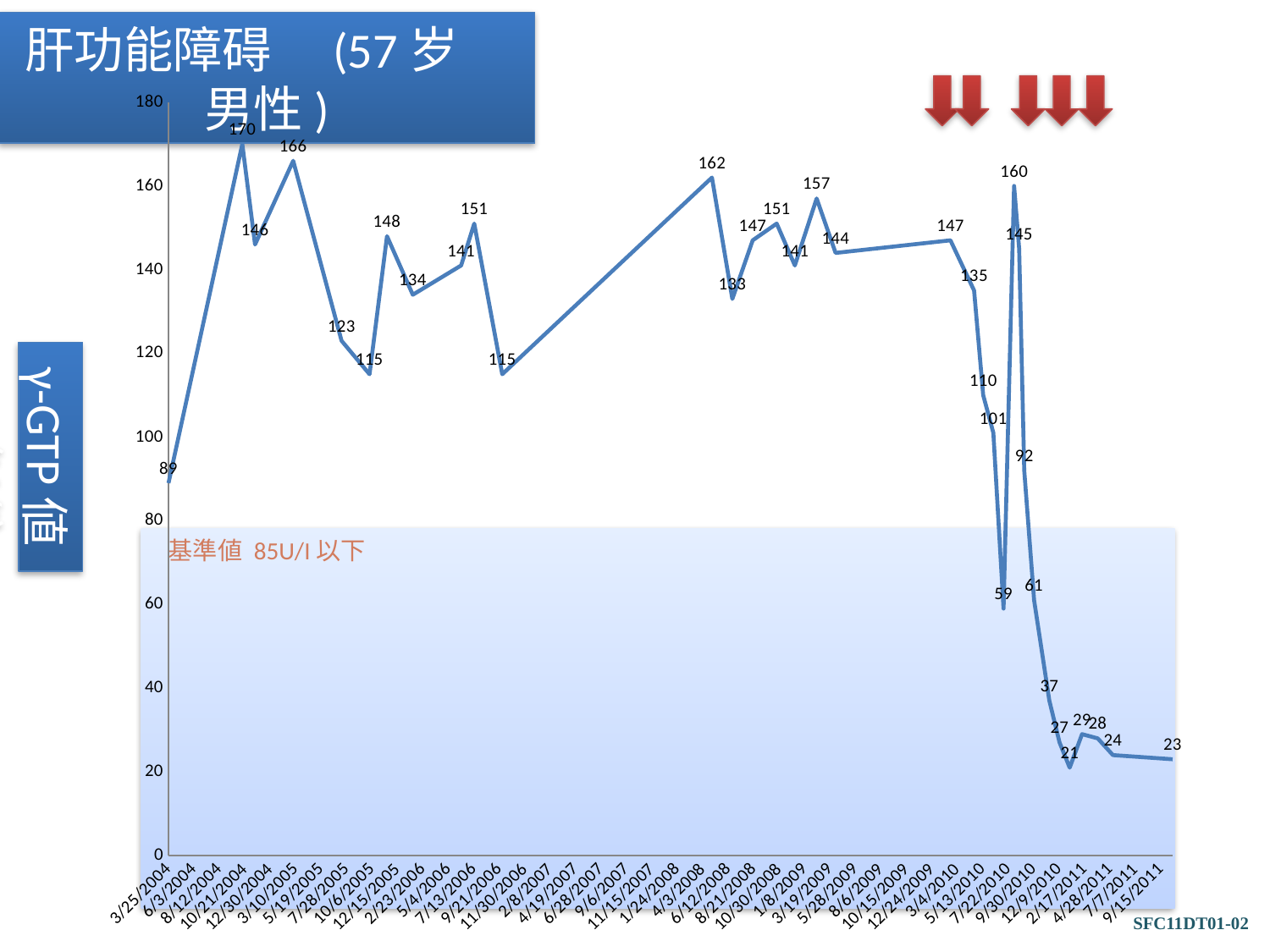
Is the last plotted γ-GTP value greater or less than 40? less What is the difference between the highest and lowest γ-GTP values on the chart? 149 What is the label on the vertical axis of the chart? γ-GTP 値 Overall, do the γ-GTP values rise or fall from the start to the end of the chart? fall What is the lowest γ-GTP value plotted on the chart? 21 What baseline (基準値) is stated in the shaded area of the chart? 85U/l 以下 Which is larger, the first plotted value or the last plotted value? the first plotted value (89) What is the difference between the first plotted value (89) and the last plotted value (23)? 66 What is the highest γ-GTP value plotted on the chart? 170 What kind of chart is shown on the slide? line chart What is the first γ-GTP value plotted on the chart (at 3/25/2004)? 89 What is the last γ-GTP value plotted on the chart (at 9/15/2011)? 23